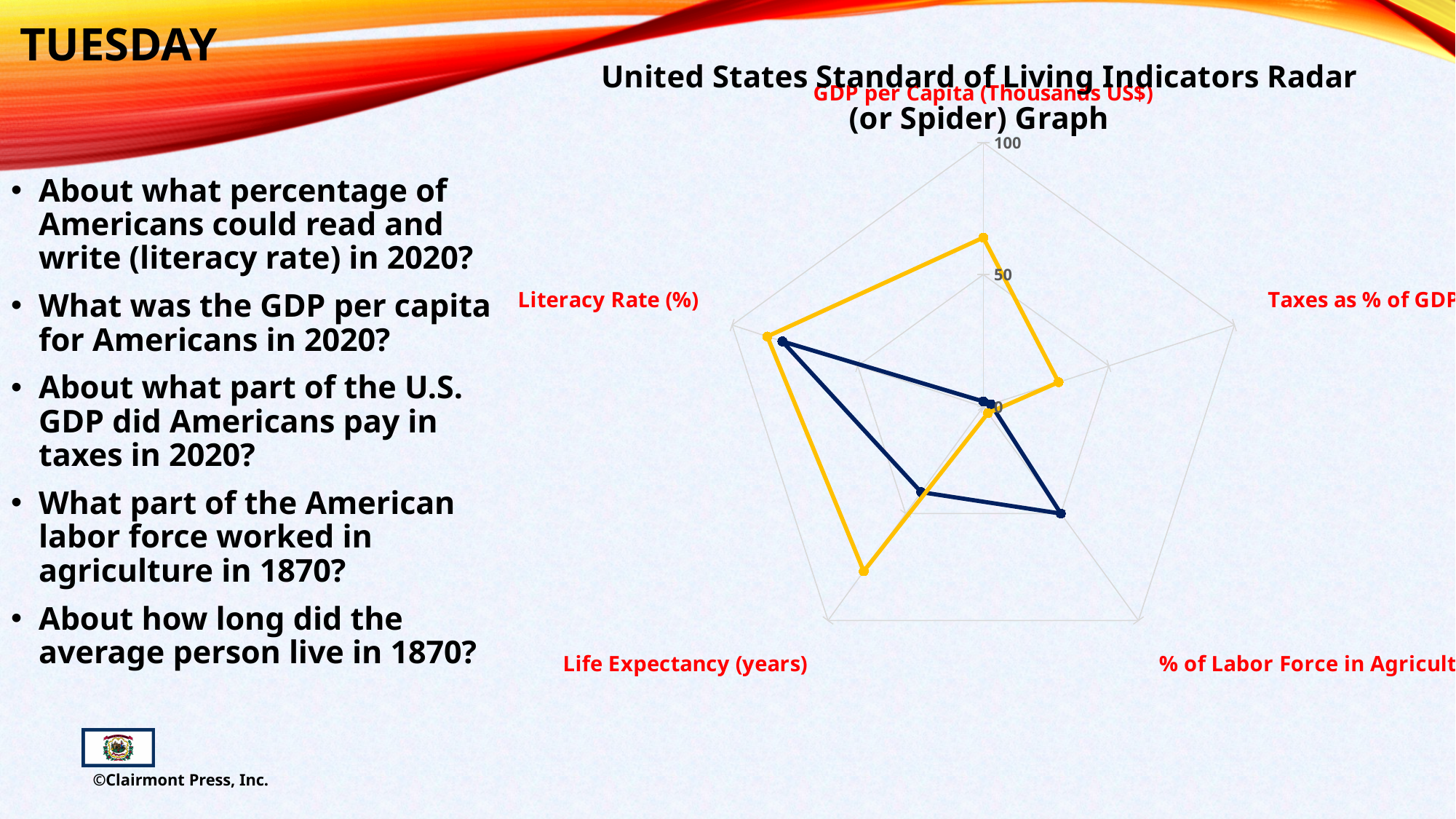
Is the dark blue series' value for Literacy Rate (%) greater or less than 50? greater What kind of chart is shown on the slide? Radar chart Is the yellow series' value for Life Expectancy (years) greater or less than 50? greater What is the highest value shown on the radar chart's axis scale? 100 Is the yellow series' value for Literacy Rate (%) greater or less than 50? greater How many categories (axes) does the radar chart have? 5 Which series has the larger value for Life Expectancy (years), the yellow series or the dark blue series? The yellow series What is the title of the chart? United States Standard of Living Indicators Radar (or Spider) Graph How many data series are plotted on the radar chart? 2